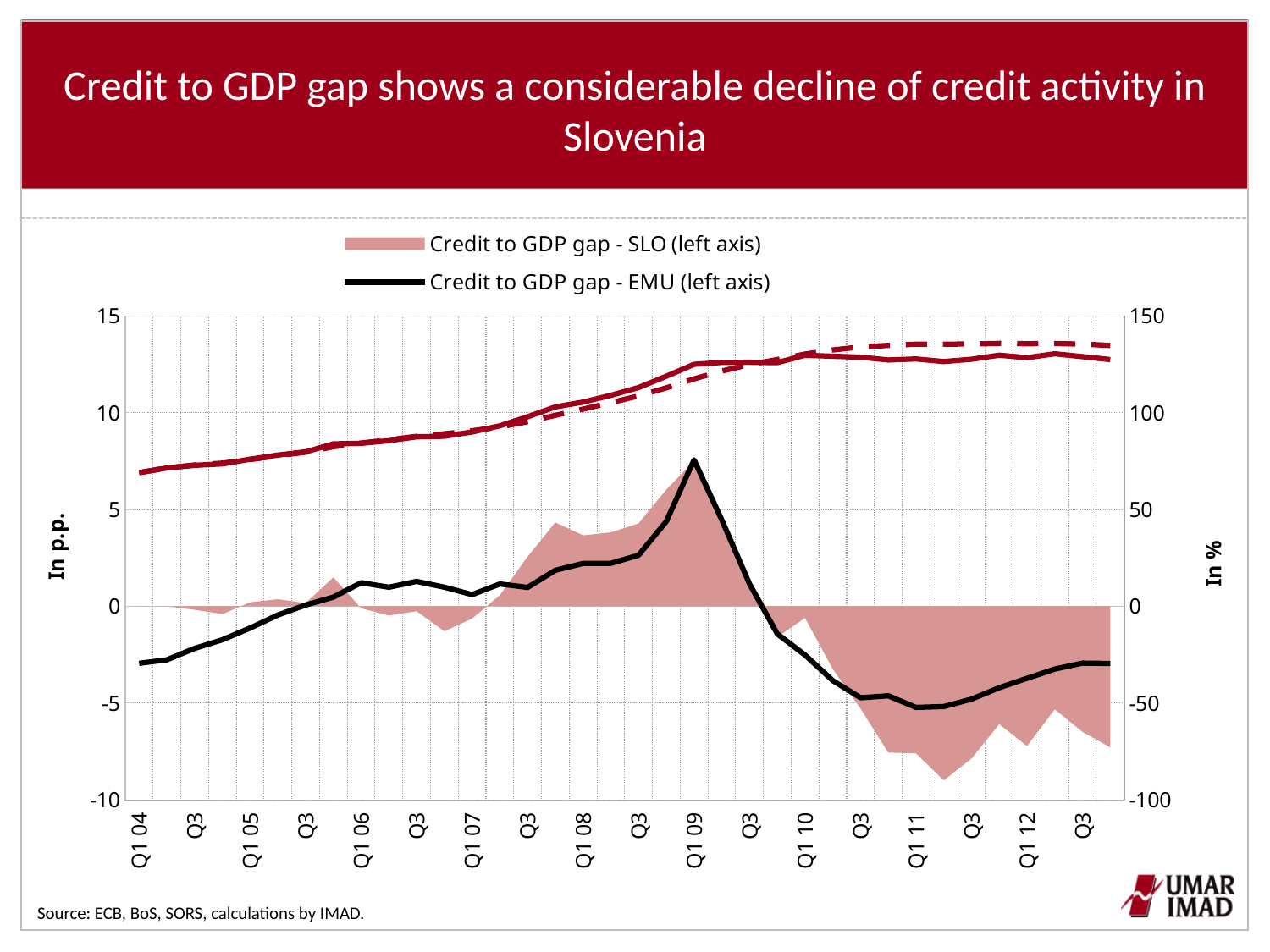
How many series does the chart legend list? 2 Is the value of the Credit to GDP gap - EMU line at Q1 09 greater or less than 5? greater What is the label of the right vertical axis? In % Is the value of the Credit to GDP gap - SLO area at Q1 08 greater or less than 0? greater In which quarter does the Credit to GDP gap - EMU line reach its highest value? Q1 09 Is the value of the Credit to GDP gap - EMU line at Q1 04 greater or less than 0? less What is the label of the left vertical axis? In p.p. At Q1 08, which is larger: the Credit to GDP gap - SLO or the Credit to GDP gap - EMU? Credit to GDP gap - SLO At Q1 11, which is larger: the Credit to GDP gap - SLO or the Credit to GDP gap - EMU? Credit to GDP gap - EMU What is the highest value shown on the right vertical axis? 150 Does the Credit to GDP gap - EMU line rise or fall between Q1 04 and Q1 09? rise